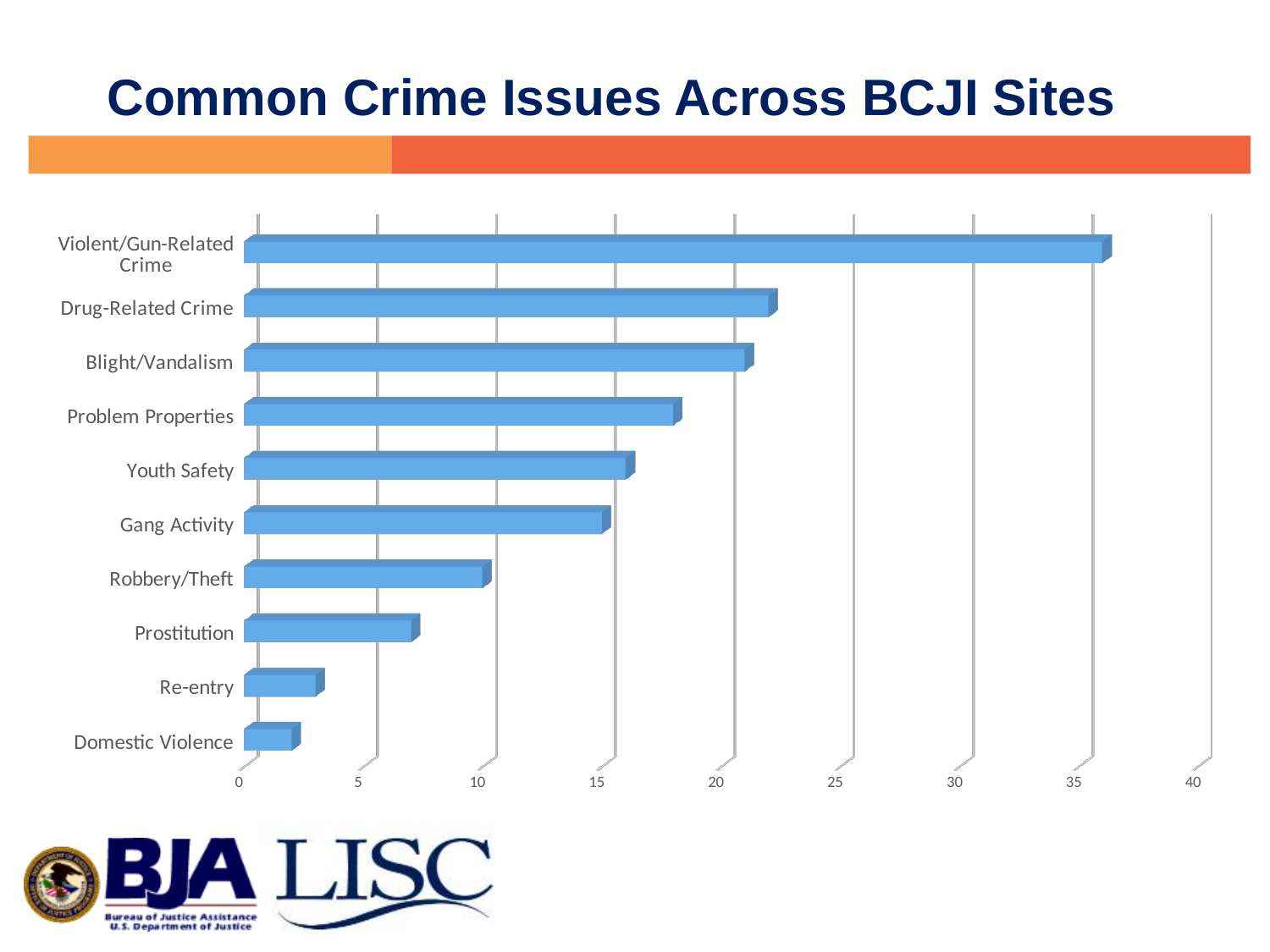
Which has a larger value, Robbery/Theft or Prostitution? Robbery/Theft Which crime issue has the lowest value in the chart? Domestic Violence Which crime issue has the highest value in the chart? Violent/Gun-Related Crime Is the value for Re-entry greater or less than 5? less Is the value for Prostitution greater or less than 10? less How many crime issue categories are plotted in the chart? 10 What is the title of the slide? Common Crime Issues Across BCJI Sites Which has a larger value, Gang Activity or Domestic Violence? Gang Activity Is the value for Drug-Related Crime greater or less than 20? greater What kind of chart is shown on the slide? Bar chart